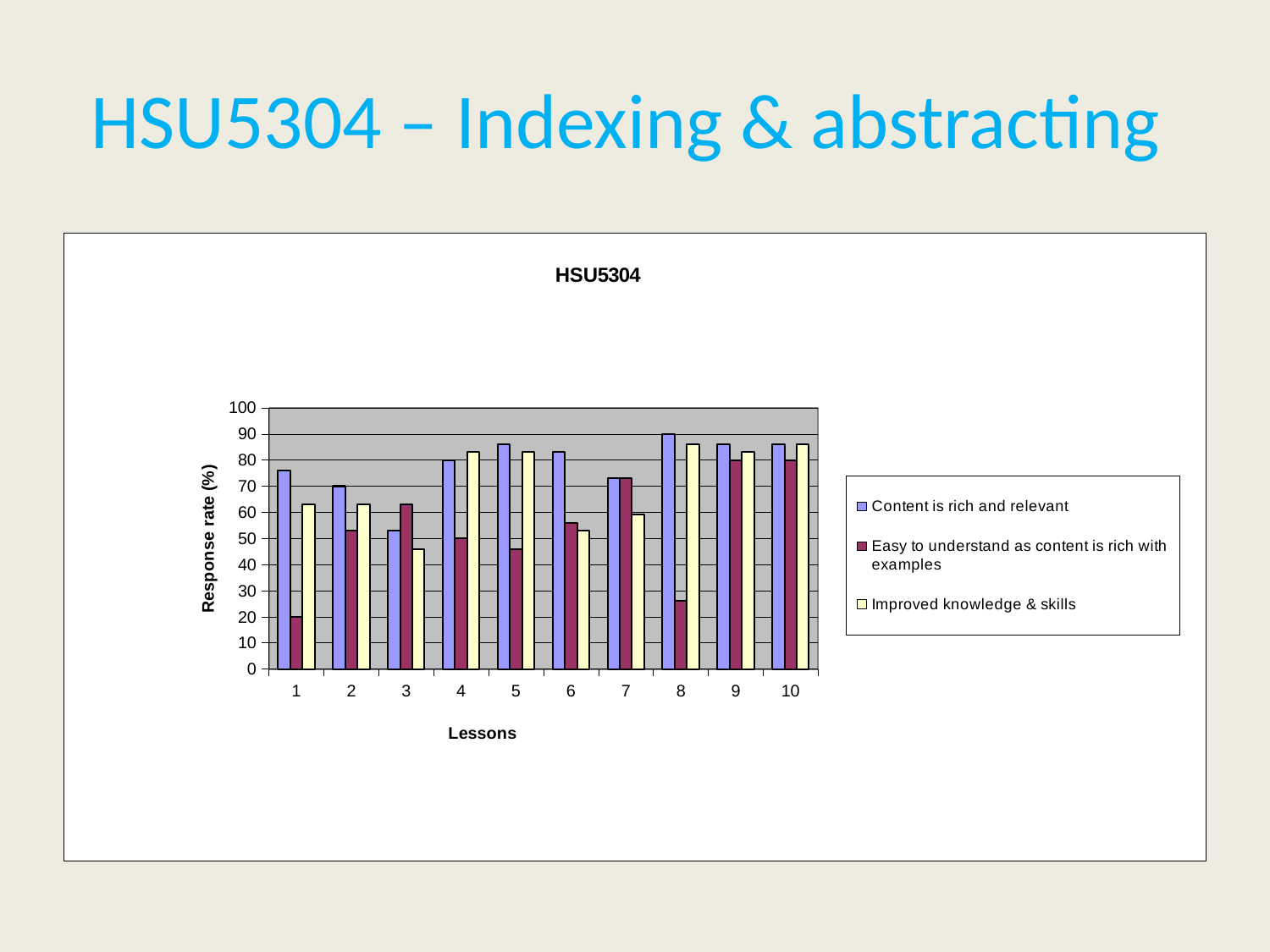
Is the value for 'Easy to understand as content is rich with examples' at Lesson 8 greater or less than 30? less At Lesson 6, which is larger: 'Content is rich and relevant' or 'Improved knowledge & skills'? Content is rich and relevant How many series does the legend list? 3 Is the value for 'Content is rich and relevant' at Lesson 5 greater or less than 80? greater How many lessons are shown on the x axis? 10 Which lesson has the highest value for 'Content is rich and relevant'? Lesson 8 Which lesson has the lowest value for 'Easy to understand as content is rich with examples'? Lesson 1 What kind of chart is shown on the slide? bar chart What is the title of the y axis? Response rate (%) Is the value for 'Improved knowledge & skills' at Lesson 3 greater or less than 50? less At Lesson 3, which is larger: 'Content is rich and relevant' or 'Easy to understand as content is rich with examples'? Easy to understand as content is rich with examples What is the value for 'Content is rich and relevant' at Lesson 8? 90